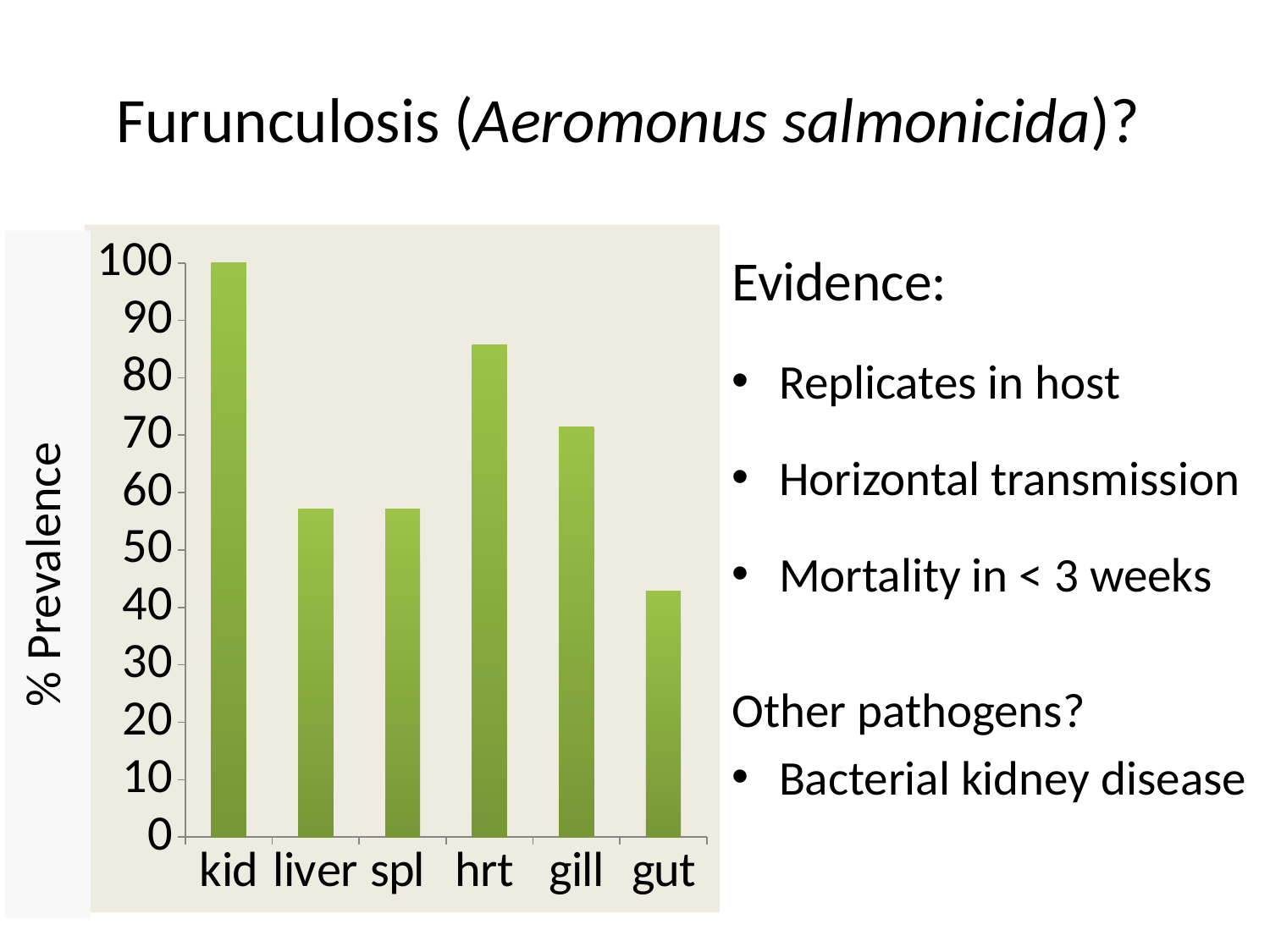
Which is larger, the value for hrt or the value for gill? hrt Is the value for hrt greater or less than 80? greater How many categories are shown on the x axis of the chart? 6 Which category has the lowest % Prevalence? gut Which category has the highest % Prevalence? kid Is the value for gut greater or less than 50? less What is the label of the y axis of the chart? % Prevalence What is the % Prevalence value for kid? 100 What kind of chart is shown on the slide? bar chart Which is larger, the value for spl or the value for gut? spl Is the value for gill greater or less than 80? less